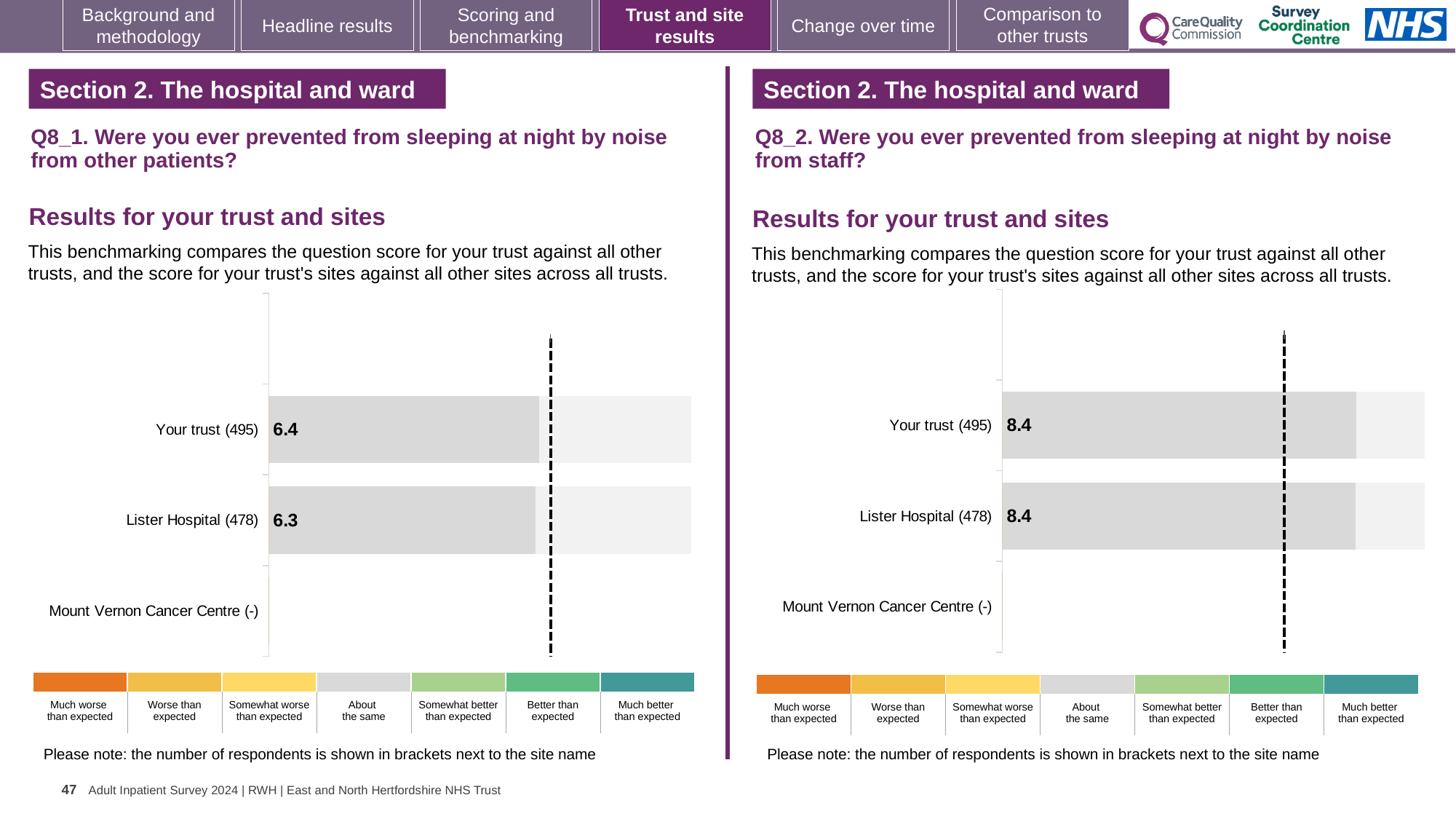
In the Q8_2 chart (right), what is the difference between the scores for Your trust and Lister Hospital? 0 What kind of chart is used in the Q8_2 chart (right)? Bar chart In the Q8_1 chart (left), what is the score for Lister Hospital? 6.3 In the Q8_1 chart (left), what is the difference between the scores for Your trust and Lister Hospital? 0.1 How many benchmark categories does the colour legend below the Q8_2 chart (right) list? 7 In the Q8_2 chart (right), which site has no score shown? Mount Vernon Cancer Centre In the Q8_2 chart (right), what is the score for Lister Hospital? 8.4 In the Q8_1 chart (left), how many respondents are shown in brackets for Lister Hospital? 478 In the Q8_1 chart (left), what is the score for Your trust? 6.4 In the Q8_1 chart (left), which has the higher score, Your trust or Lister Hospital? Your trust How many site/trust categories are listed on the y axis of the Q8_1 chart (left)? 3 In the Q8_2 chart (right), what is the score for Your trust? 8.4